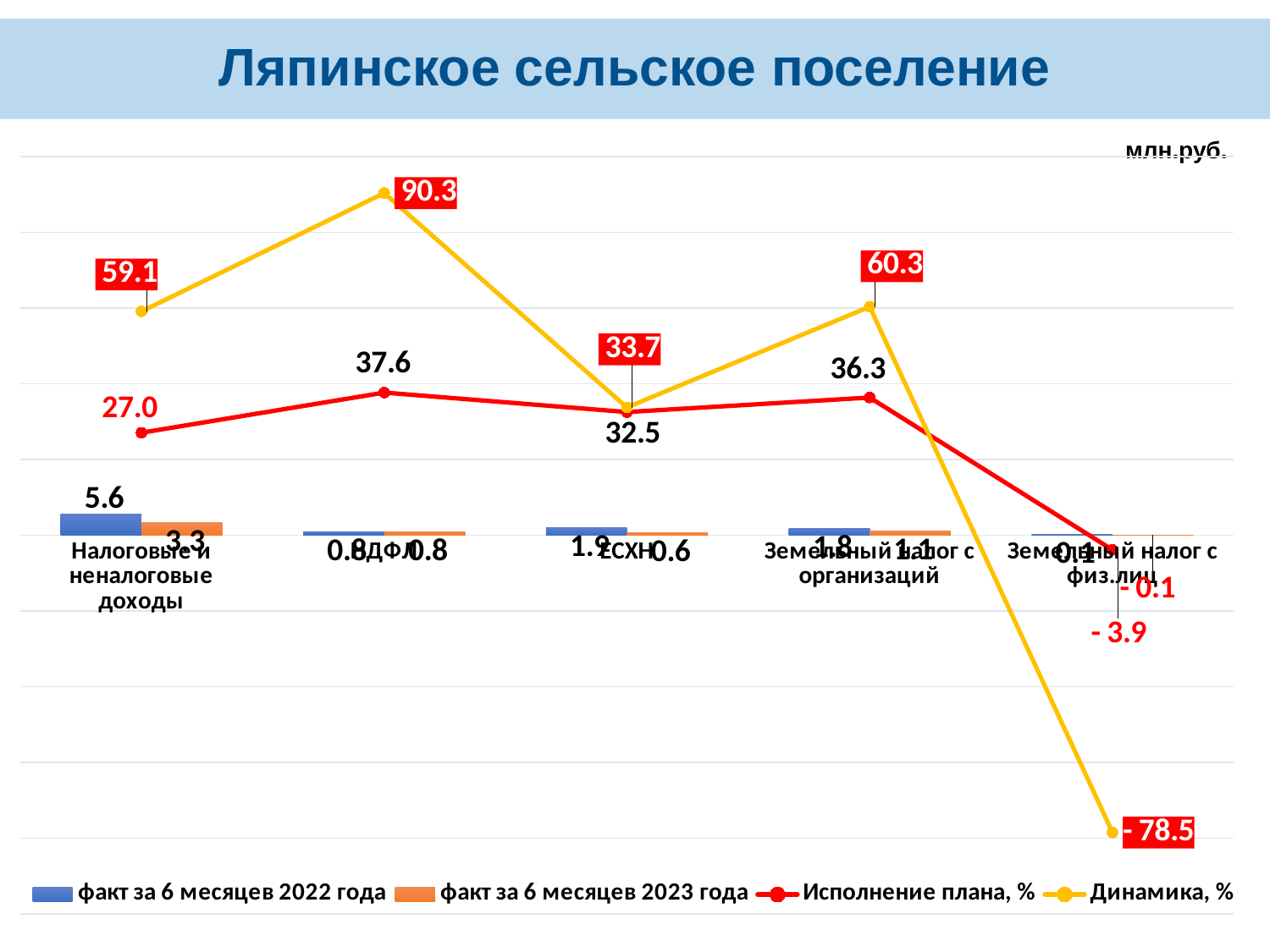
Which category has the lowest value of Динамика, %? Земельный налог с физ.лиц What is the value of факт за 6 месяцев 2022 года for Налоговые и неналоговые доходы? 5.6 What kind of chart is shown on the slide? A combined bar and line chart What is the difference between факт за 6 месяцев 2022 года and факт за 6 месяцев 2023 года for Налоговые и неналоговые доходы? 2.3 Which category has the highest value of Динамика, %? НДФЛ How many series does the legend list? 4 What is the value of Динамика, % for Земельный налог с физ.лиц? - 78.5 What is the value of Динамика, % for НДФЛ? 90.3 What is the value of Исполнение плана, % for Земельный налог с организаций? 36.3 How many categories are shown along the x axis? 5 Which has the higher Исполнение плана, %: НДФЛ or ЕСХН? НДФЛ Which category has the highest value of Исполнение плана, %? НДФЛ